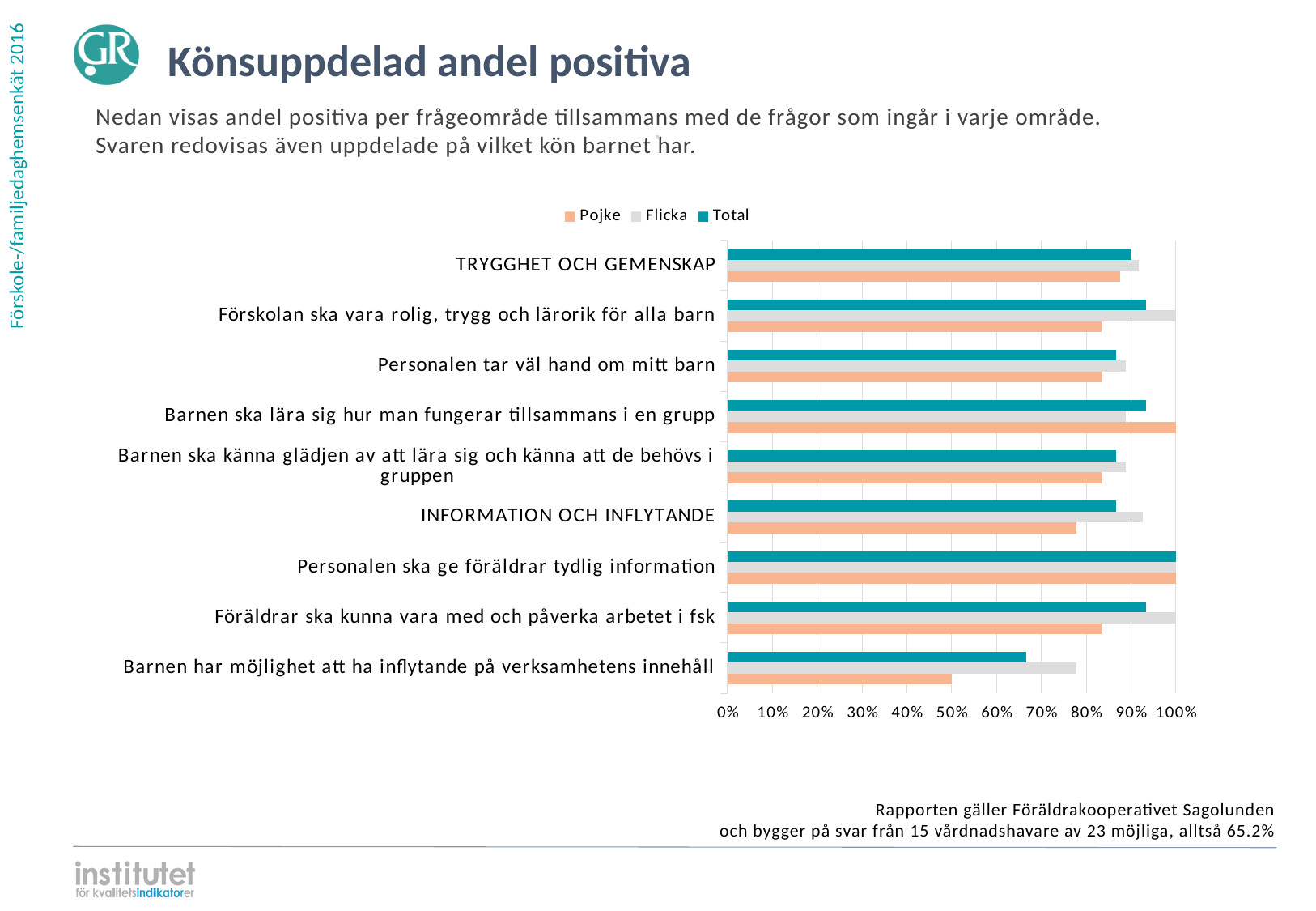
For "Barnen har möjlighet att ha inflytande på verksamhetens innehåll", which is larger: the Pojke value or the Flicka value? Flicka What is the Flicka value for "Förskolan ska vara rolig, trygg och lärorik för alla barn"? 100% Which series is shown in orange in the legend? Pojke How many categories are plotted on the chart? 9 Is the Pojke value for "INFORMATION OCH INFLYTANDE" greater or less than 80%? less Is the Total value for "Barnen har möjlighet att ha inflytande på verksamhetens innehåll" greater or less than 60%? greater Which category has the lowest Pojke value? Barnen har möjlighet att ha inflytande på verksamhetens innehåll What is the Pojke value for "Personalen ska ge föräldrar tydlig information"? 100% How many series does the legend list? 3 What kind of chart is shown on the slide? bar chart What is the Pojke value for "Barnen ska lära sig hur man fungerar tillsammans i en grupp"? 100% What is the Pojke value for "Barnen har möjlighet att ha inflytande på verksamhetens innehåll"? 50%